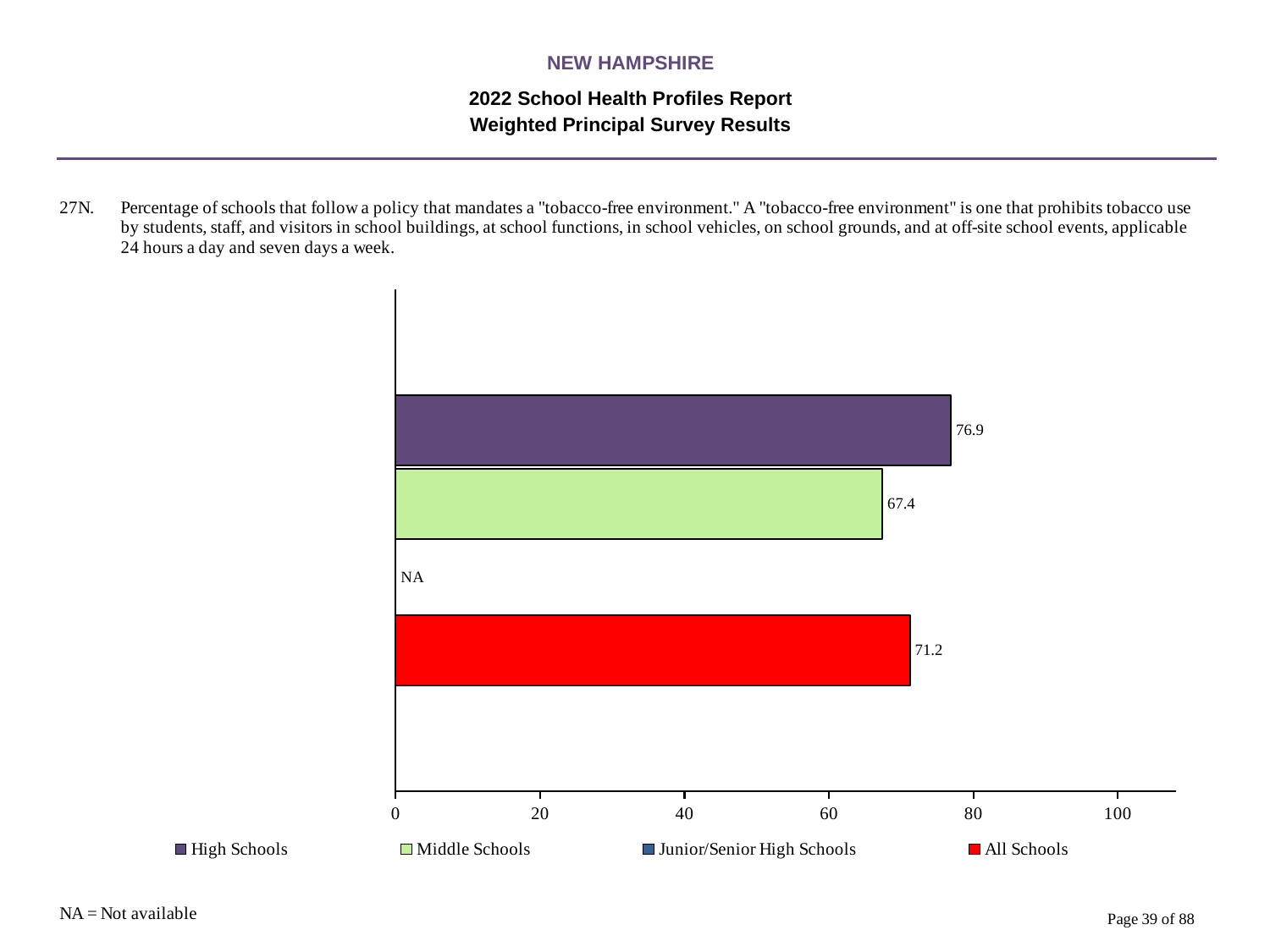
What is shown for Junior/Senior High Schools? NA What is the value for High Schools? 76.9 What is the value for All Schools? 71.2 What is the value for Middle Schools? 67.4 What kind of chart is shown on the slide? bar chart How many series does the legend list? 4 Which is larger, the value for High Schools or the value for All Schools? High Schools Is the value for Middle Schools greater or less than 80? less What is the difference between the All Schools and Middle Schools values? 3.8 Which school type with a plotted value has the lowest value? Middle Schools Which school type has the highest value? High Schools What is the difference between the High Schools and Middle Schools values? 9.5